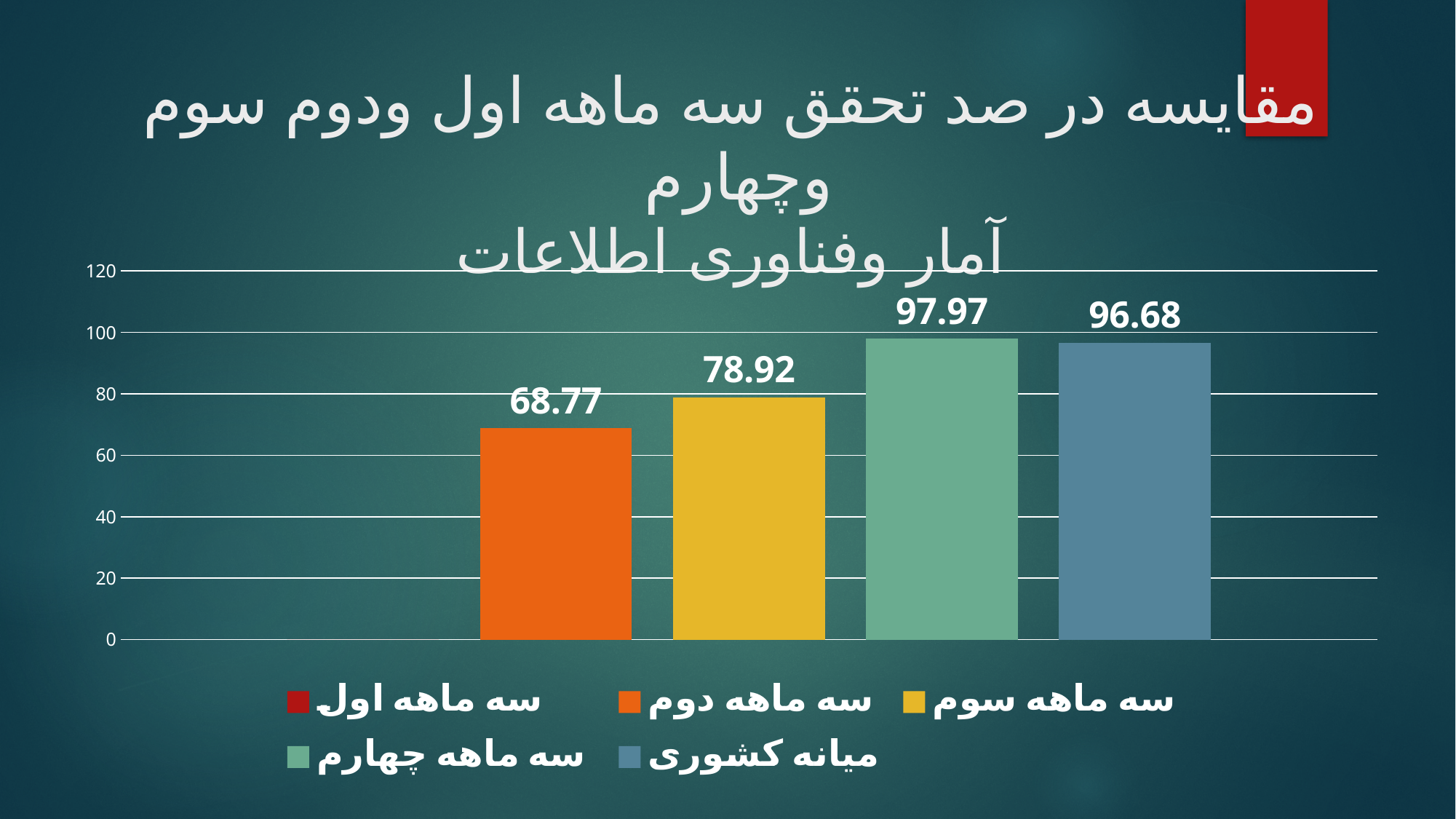
What is the difference between the values for سه ماهه چهارم and میانه کشوری? 1.29 Which is larger, the value for سه ماهه سوم or the value for میانه کشوری? میانه کشوری Which of the labeled bars has the lowest value? سه ماهه دوم What is the difference between the values for سه ماهه سوم and سه ماهه دوم? 10.15 What is the value for سه ماهه چهارم? 97.97 Which series has the highest value on the chart? سه ماهه چهارم What kind of chart is shown on the slide? bar chart What is the value for میانه کشوری? 96.68 What is the value for سه ماهه دوم? 68.77 How many series does the legend list? 5 Is the value for سه ماهه دوم greater or less than 80? less What is the value for سه ماهه سوم? 78.92